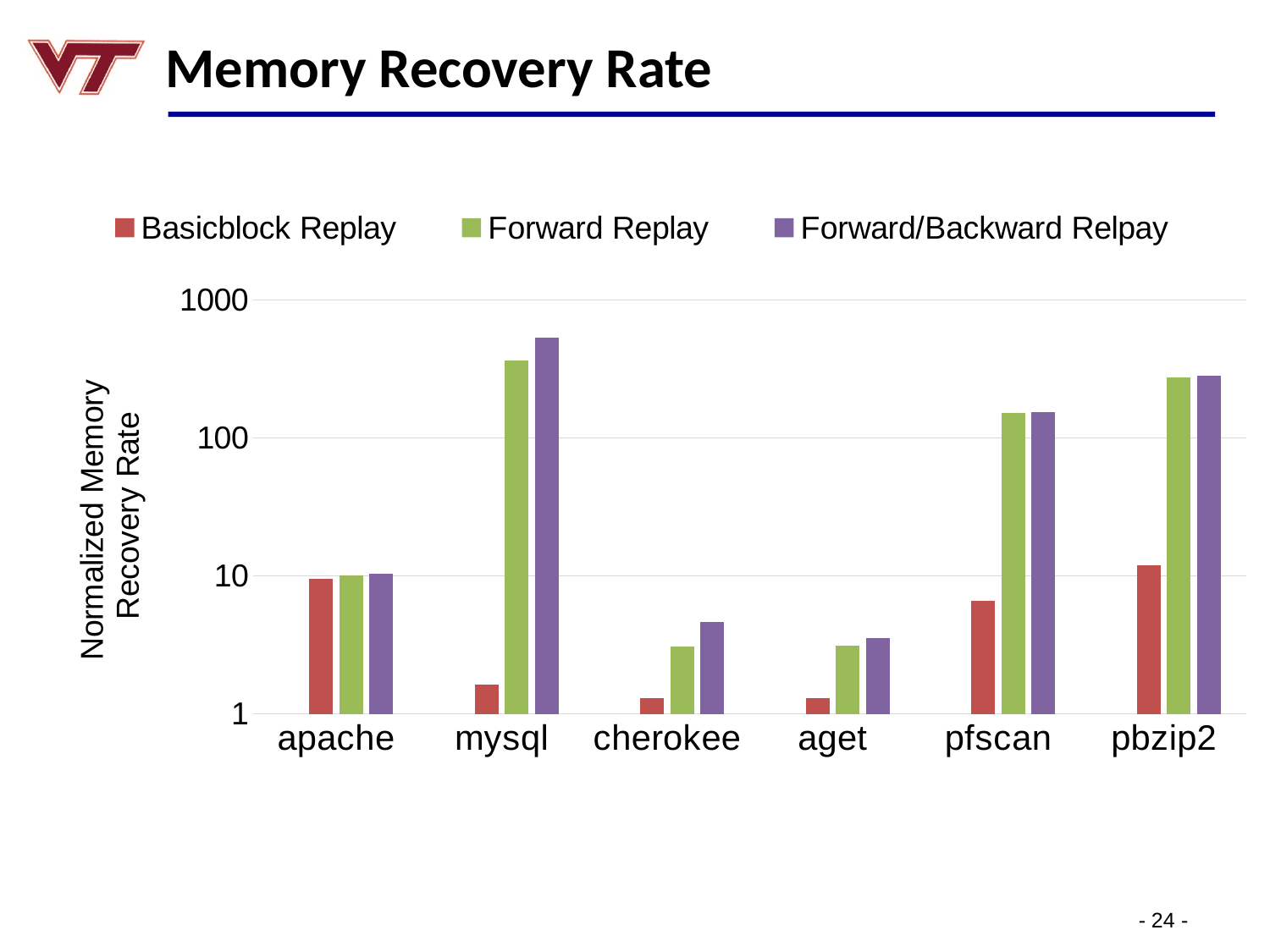
Which series is shown in green in the legend? Forward Replay Is the Forward Replay value for pfscan greater or less than 100? greater Is the Basicblock Replay value for aget greater or less than 10? less Is the Forward Replay value for cherokee greater or less than 10? less Which category has the highest Forward/Backward Relpay value? mysql Which is larger for cherokee, the Forward Replay value or the Forward/Backward Relpay value? Forward/Backward Relpay How many categories are shown on the x axis of the chart? 6 How many series does the legend list? 3 What is the label of the y axis? Normalized Memory Recovery Rate Which is larger, the Forward Replay value for mysql or the Forward Replay value for pfscan? mysql What kind of chart is shown on the slide? bar chart